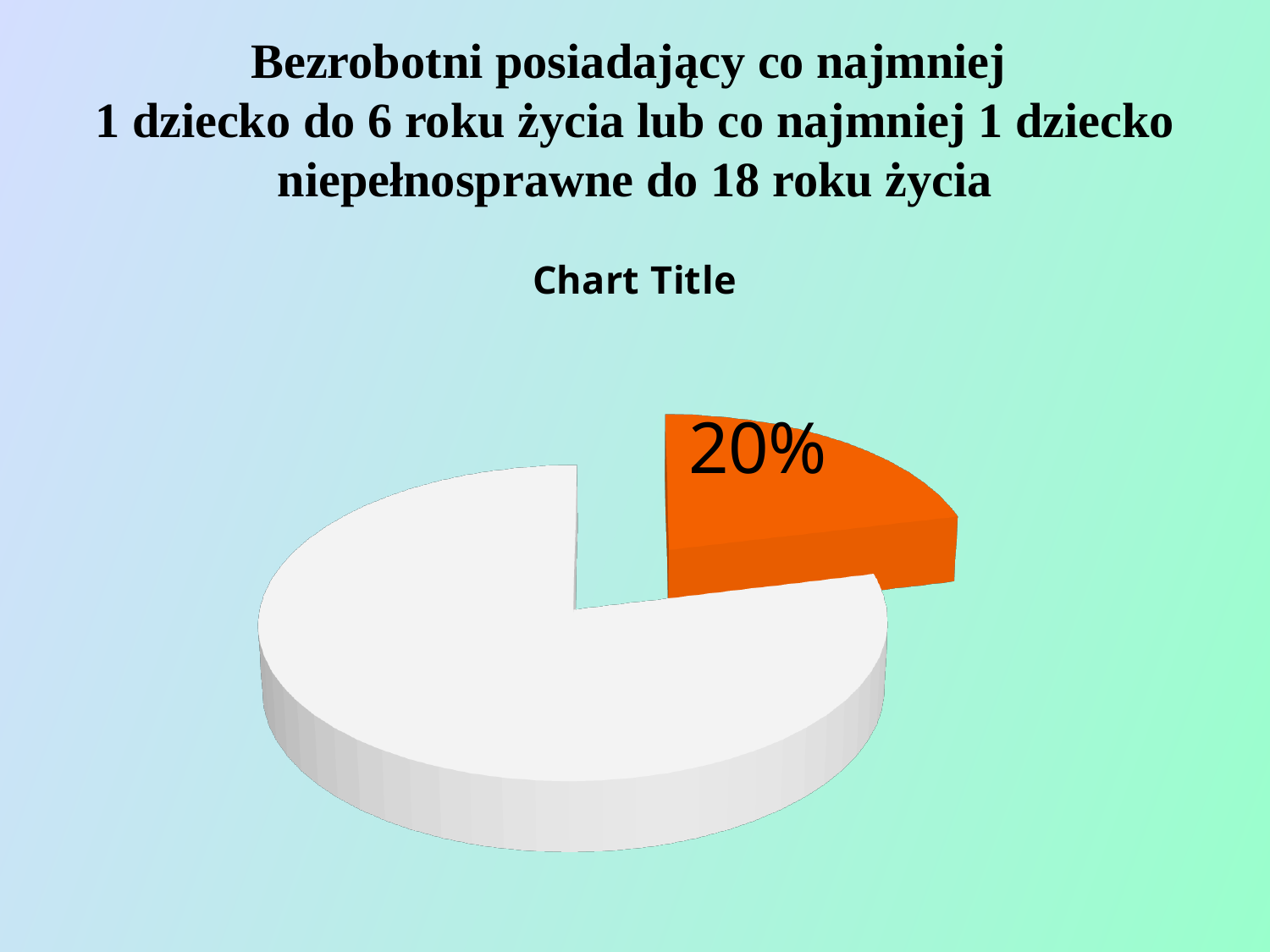
Which slice is the largest in the pie chart? the white slice What colour is the slice that carries the 20% label? orange How many slices does the pie chart have? 2 Which slice is the smallest in the pie chart? the orange slice (20%) What kind of chart is shown on the slide? pie chart Which slice of the pie chart is larger, the orange slice or the white slice? the white slice What title is displayed directly above the pie chart? Chart Title What percentage is printed on the orange slice of the pie chart? 20% What share of the pie does the orange slice represent? 20%